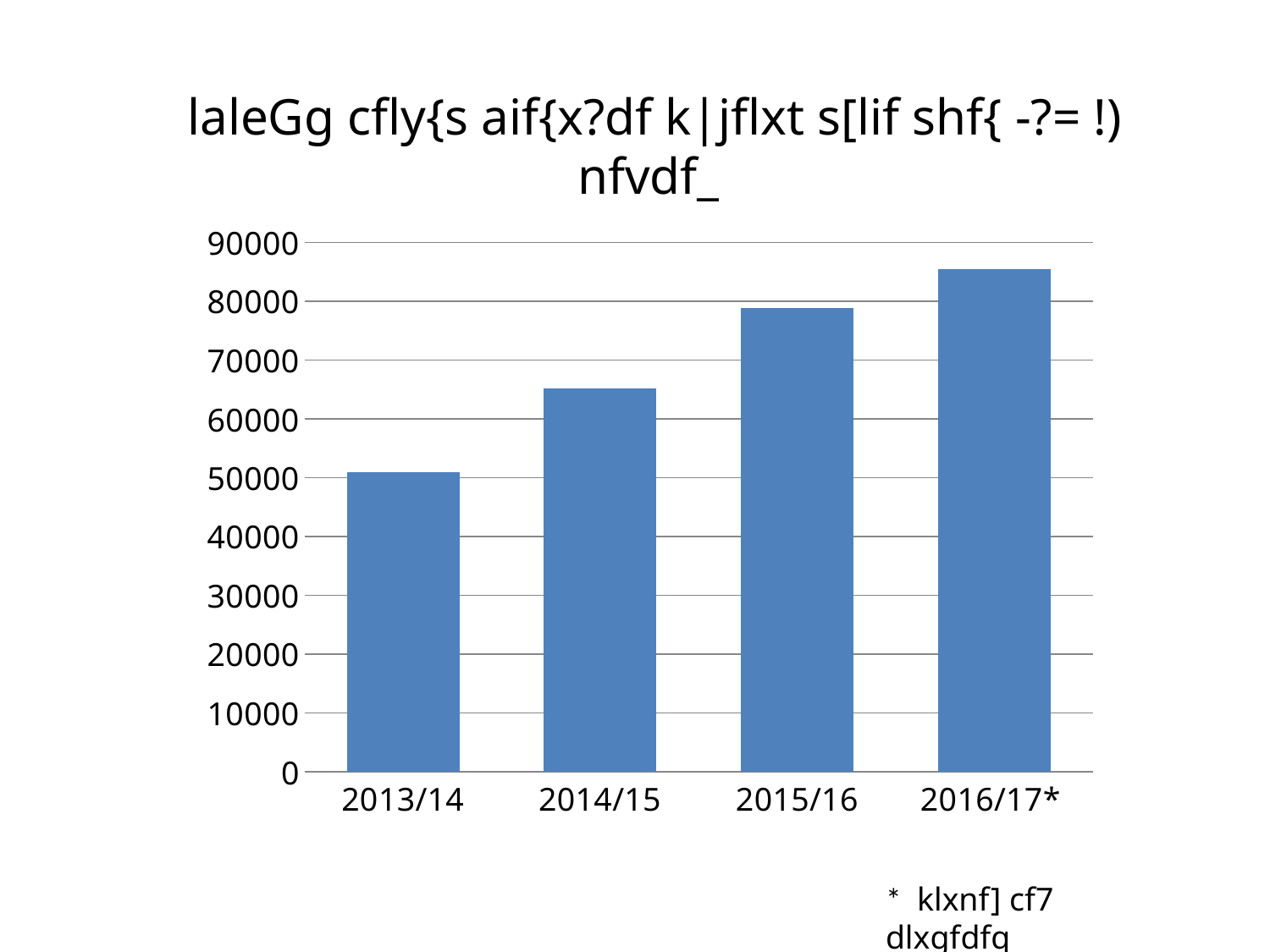
Which category has the lowest bar? 2013/14 What colour are the bars in the chart? blue Is the value for 2014/15 greater or less than 60000? greater What kind of chart is shown on the slide? bar chart Do the values rise or fall from 2013/14 to 2016/17*? rise Is the value for 2013/14 greater or less than 60000? less How many categories are shown on the x axis of the chart? 4 Which category has the highest bar? 2016/17* Which is larger, the value for 2014/15 or the value for 2015/16? 2015/16 Is the value for 2016/17* greater or less than 80000? greater What is the highest value shown on the y axis? 90000